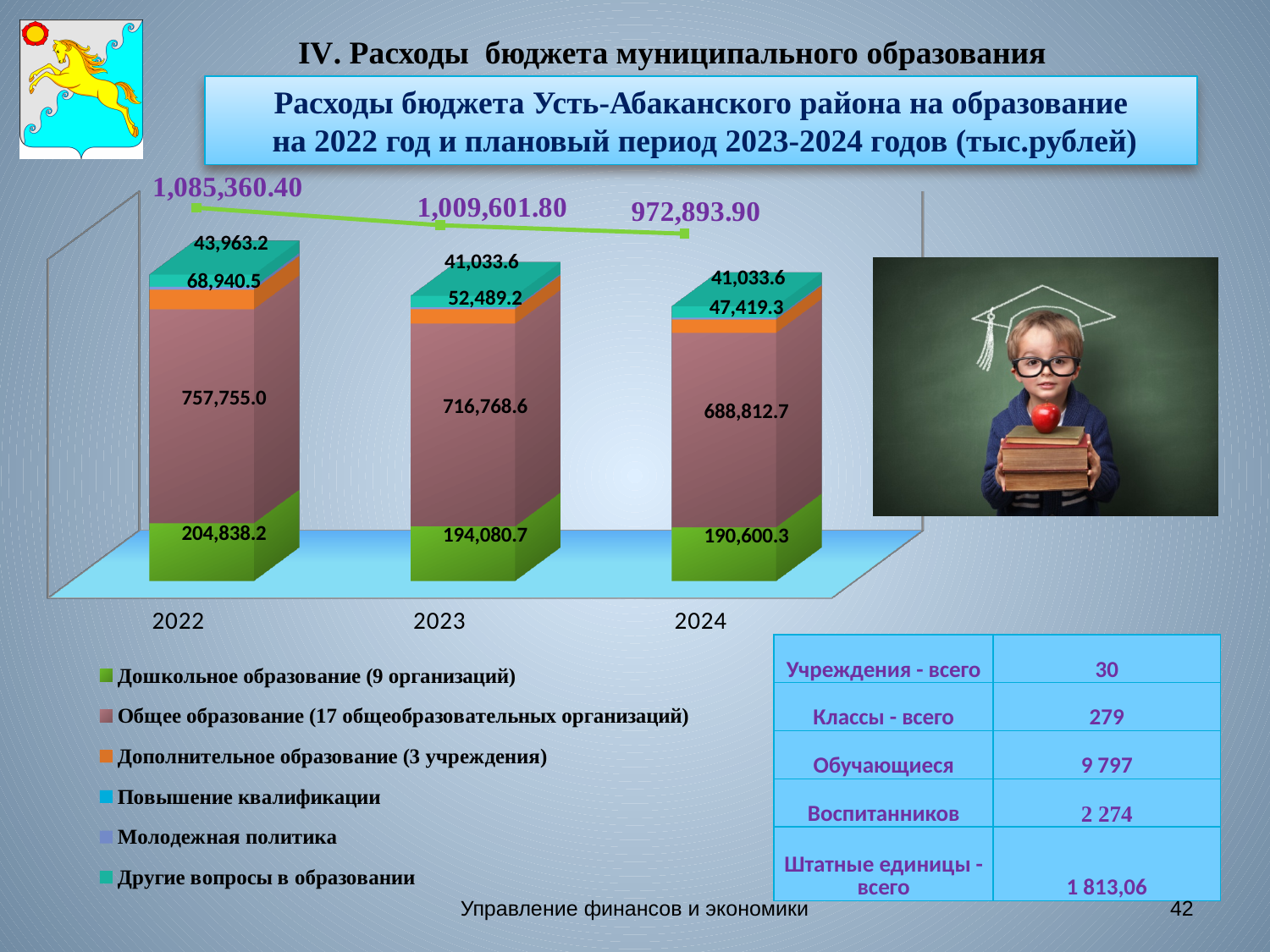
What is the difference between the Общее образование values for 2022 and 2023? 40,986.4 Which year has the lowest value for Общее образование? 2024 What is the difference between the Дошкольное образование values for 2022 and 2024? 14,237.9 Which year has the highest total education expenditure? 2022 What kind of chart is used to show the education expenditure? Stacked bar chart Which year has the larger value for Дополнительное образование, 2022 or 2024? 2022 What is the value for Дополнительное образование in 2023? 52,489.2 How many series does the legend list? 6 How many years are shown on the x axis of the chart? 3 What is the value for Общее образование in 2024? 688,812.7 What is the total education expenditure shown for 2022? 1,085,360.40 What is the value for Дошкольное образование in 2022? 204,838.2